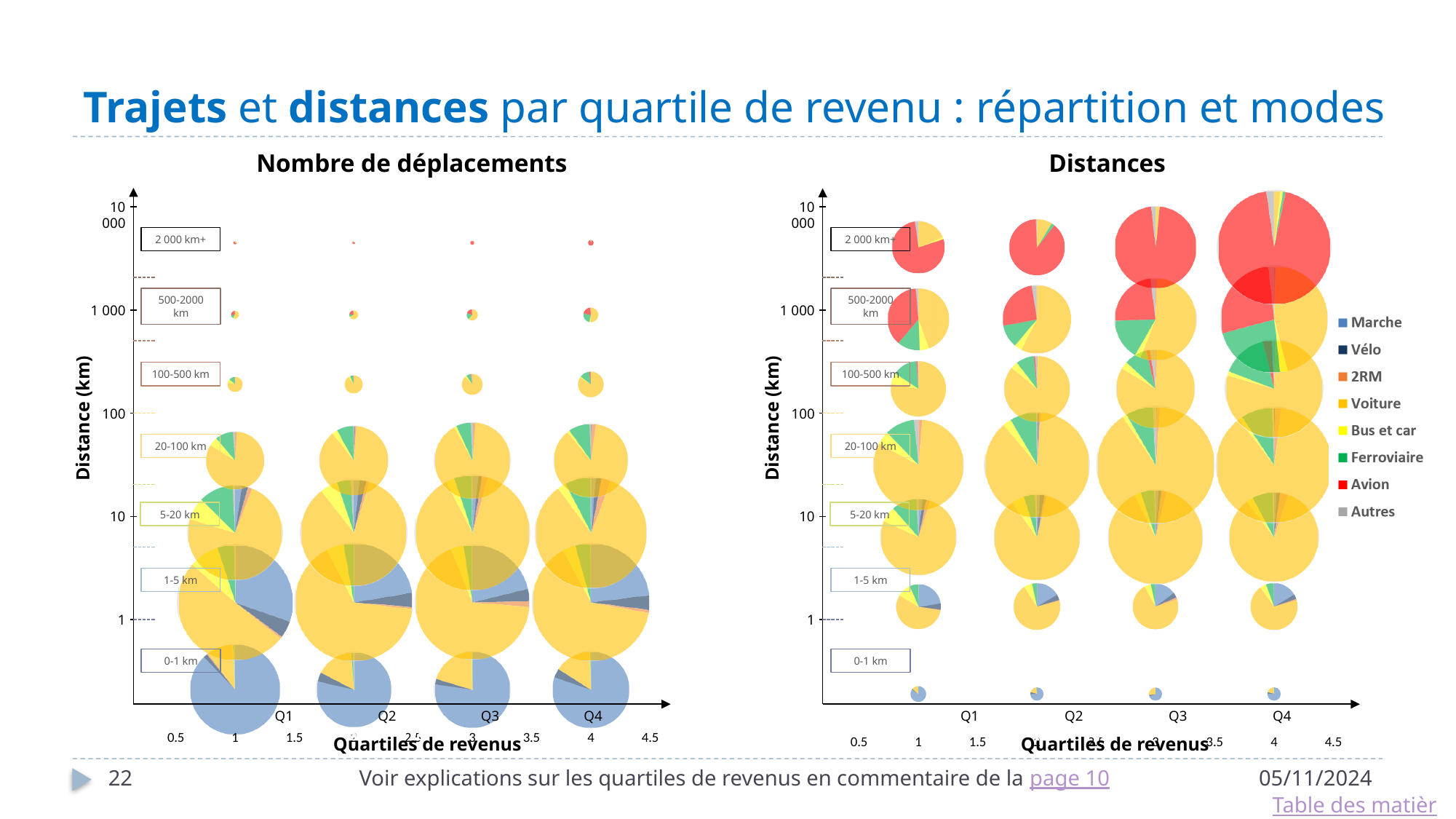
What is the title of the chart on the right? Distances How many charts are shown on the slide? 2 In the 'Nombre de déplacements' chart, which mode dominates the 0-1 km bubbles? Marche In the 'Distances' chart, which mode dominates the 2 000 km+ bubbles? Avion How many distance bands are labelled on the y axis of the 'Nombre de déplacements' chart? 7 In the 'Distances' chart, which quartile has the larger bubble for the 2 000 km+ band, Q1 or Q4? Q4 What is the title of the chart on the left? Nombre de déplacements What is the label of the y axis on the 'Distances' chart? Distance (km) In the 'Nombre de déplacements' chart, which quartile has the larger bubble for the 0-1 km band, Q1 or Q4? Q1 How many income quartiles are shown along the x axis of the 'Distances' chart? 4 How many transport modes does the legend list? 8 In the 'Distances' chart, which quartile has the largest bubble in the 2 000 km+ band? Q4